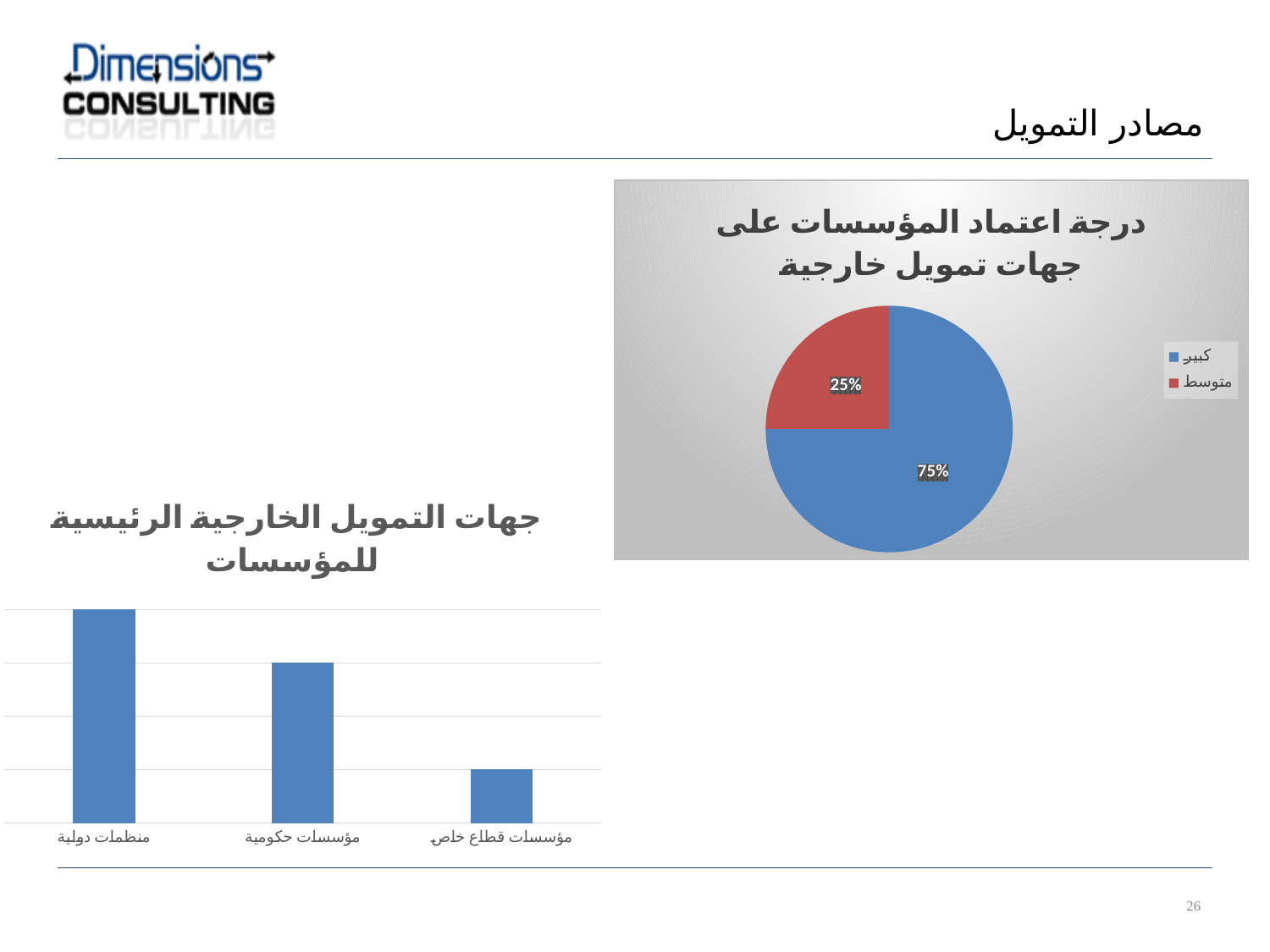
In the pie chart 'درجة اعتماد المؤسسات على جهات تمويل خارجية', what is the difference in percentage points between 'كبير' and 'متوسط'? 50% In the pie chart 'درجة اعتماد المؤسسات على جهات تمويل خارجية', what colour is the slice for 'متوسط'? Red In the bar chart 'جهات التمويل الخارجية الرئيسية للمؤسسات', which category has the highest bar? منظمات دولية What kind of chart is 'جهات التمويل الخارجية الرئيسية للمؤسسات'? Bar chart In the bar chart 'جهات التمويل الخارجية الرئيسية للمؤسسات', which category has the lowest bar? مؤسسات قطاع خاص In the pie chart 'درجة اعتماد المؤسسات على جهات تمويل خارجية', what share is labelled for 'متوسط'? 25% In the pie chart 'درجة اعتماد المؤسسات على جهات تمويل خارجية', which category has the smallest slice? متوسط In the pie chart 'درجة اعتماد المؤسسات على جهات تمويل خارجية', which category has the largest slice? كبير In the pie chart 'درجة اعتماد المؤسسات على جهات تمويل خارجية', how many entries does the legend list? 2 In the bar chart 'جهات التمويل الخارجية الرئيسية للمؤسسات', which is larger: 'مؤسسات حكومية' or 'مؤسسات قطاع خاص'? مؤسسات حكومية In the bar chart 'جهات التمويل الخارجية الرئيسية للمؤسسات', how many categories are shown? 3 In the pie chart 'درجة اعتماد المؤسسات على جهات تمويل خارجية', what share is labelled for 'كبير'? 75%